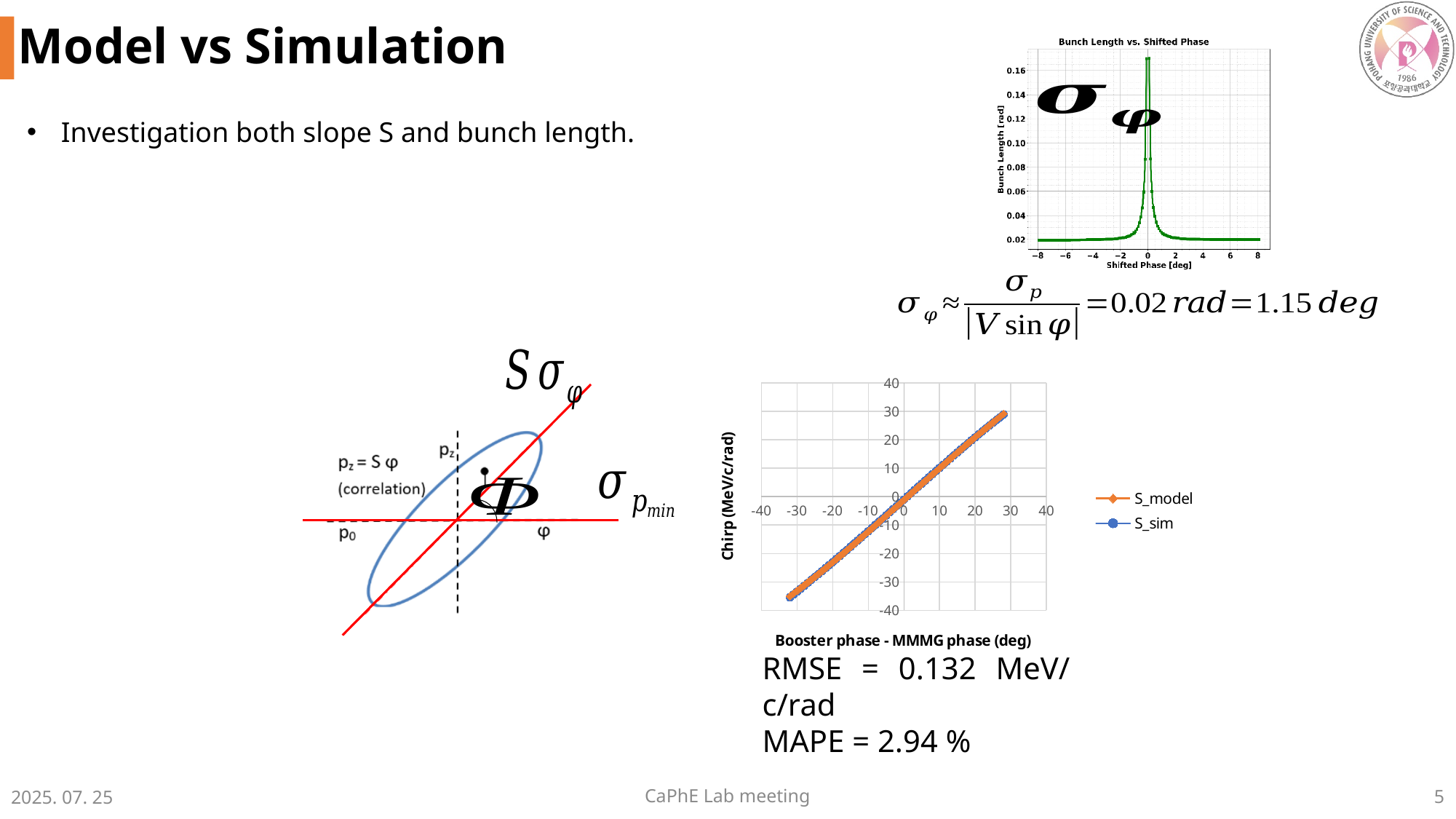
In the chirp chart at the bottom right, is the chirp at a phase difference of -30 deg greater or less than -20 MeV/c/rad? less In the chirp chart at the bottom right, how many series does the legend list? 2 In the Bunch Length vs. Shifted Phase chart, what is the label of the y axis? Bunch Length [rad] In the chirp chart at the bottom right, what are the names of the series in the legend? S_model and S_sim In the chirp chart at the bottom right, what is the highest value shown on the y axis? 40 In the Bunch Length vs. Shifted Phase chart, is the bunch length at a shifted phase of 8 deg greater or less than 0.04? less In the Bunch Length vs. Shifted Phase chart, what kind of chart is shown? line chart In the Bunch Length vs. Shifted Phase chart, is the peak bunch length greater or less than 0.14? greater In the Bunch Length vs. Shifted Phase chart, at which shifted phase does the bunch length reach its peak? 0 deg In the chirp chart at the bottom right, do the values rise or fall as the booster phase minus MMMG phase increases? rise